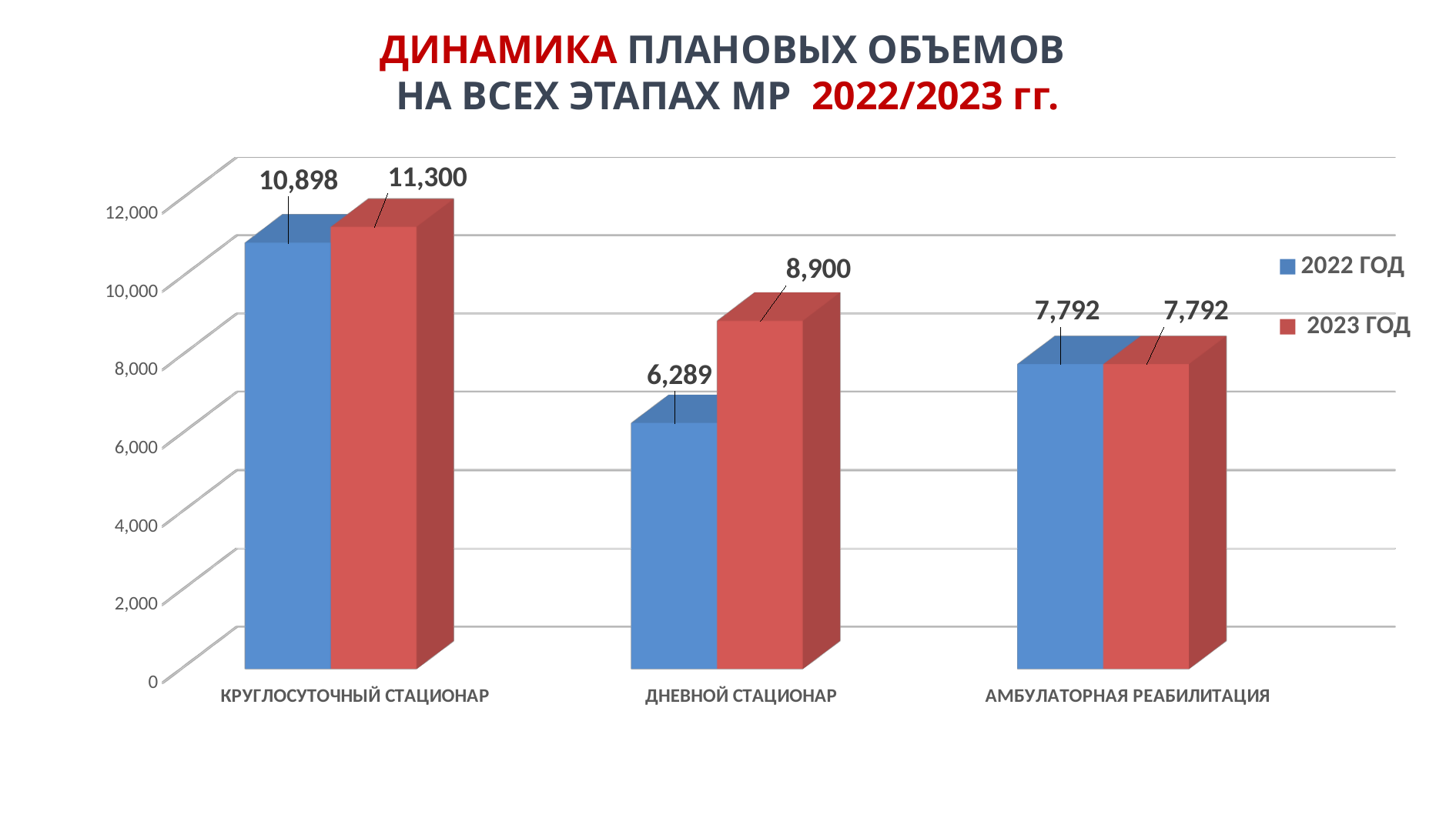
How many categories are shown on the x axis? 3 What kind of chart is shown on the slide? Bar chart Which category has the lowest value in the 2022 ГОД series? ДНЕВНОЙ СТАЦИОНАР Which is larger for ДНЕВНОЙ СТАЦИОНАР: the 2022 ГОД value or the 2023 ГОД value? 2023 ГОД How many series does the legend list? 2 Which colour represents the 2023 ГОД series? Red What is the value for КРУГЛОСУТОЧНЫЙ СТАЦИОНАР in the 2022 ГОД series? 10,898 What is the value for ДНЕВНОЙ СТАЦИОНАР in the 2023 ГОД series? 8,900 Which category has the highest value in the 2023 ГОД series? КРУГЛОСУТОЧНЫЙ СТАЦИОНАР What is the difference between the 2023 ГОД and 2022 ГОД values for ДНЕВНОЙ СТАЦИОНАР? 2,611 What is the value for АМБУЛАТОРНАЯ РЕАБИЛИТАЦИЯ in the 2022 ГОД series? 7,792 What is the difference between the 2023 ГОД and 2022 ГОД values for КРУГЛОСУТОЧНЫЙ СТАЦИОНАР? 402